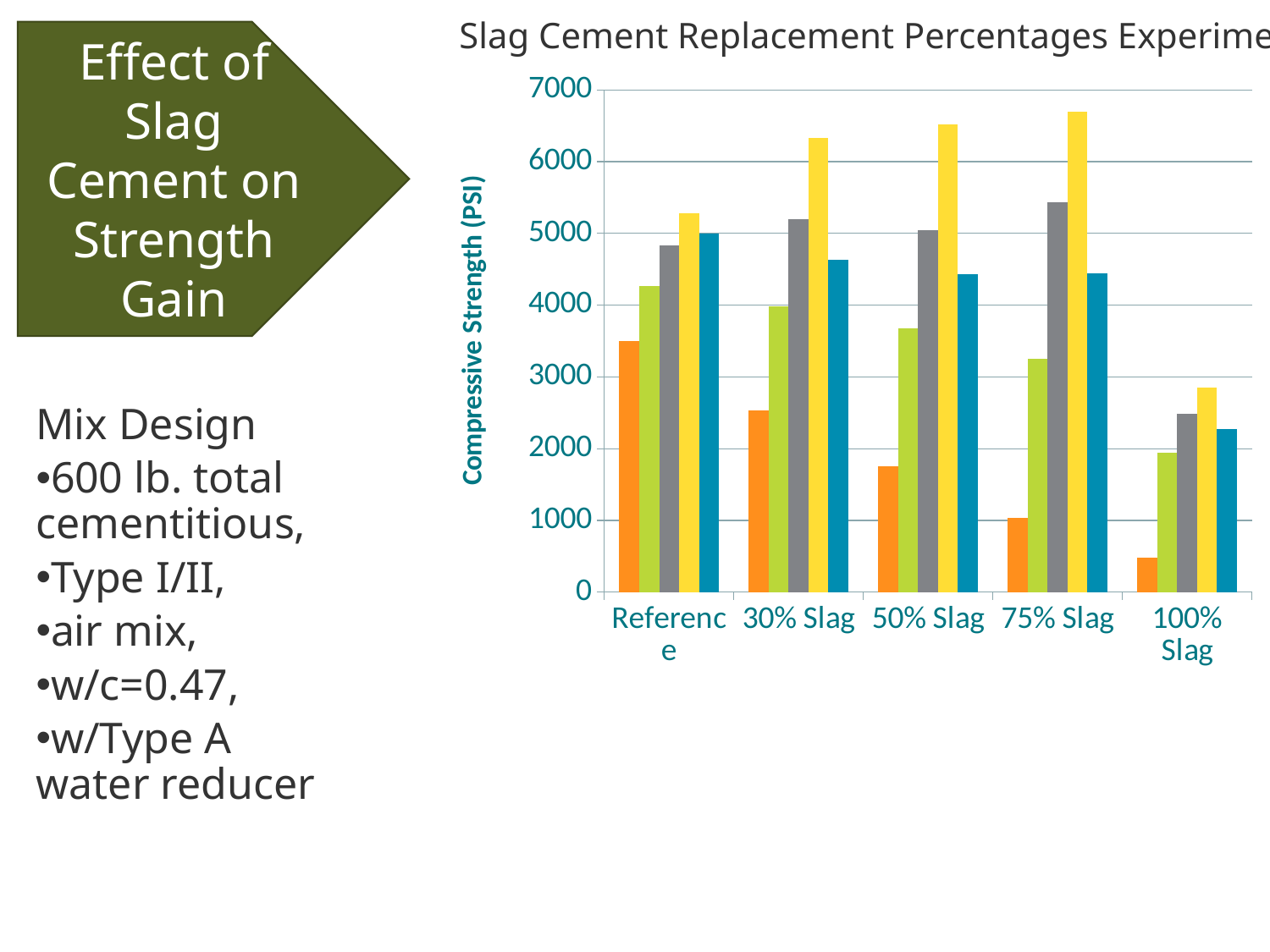
Is the value of the orange bar for 50% Slag greater or less than 2000? less Is the value of the yellow bar for 75% Slag greater or less than 6000? greater Is the value of the orange bar for Reference greater or less than 3000? greater What kind of chart is shown on the slide? bar chart Which category has the lowest orange bar? 100% Slag Do the orange bars rise or fall from Reference to 100% Slag along the x axis? fall What is the label of the vertical axis of the chart? Compressive Strength (PSI) How many bars are plotted for each category in the chart? 5 Which category has the tallest yellow bar? 75% Slag How many categories are shown along the x axis of the chart? 5